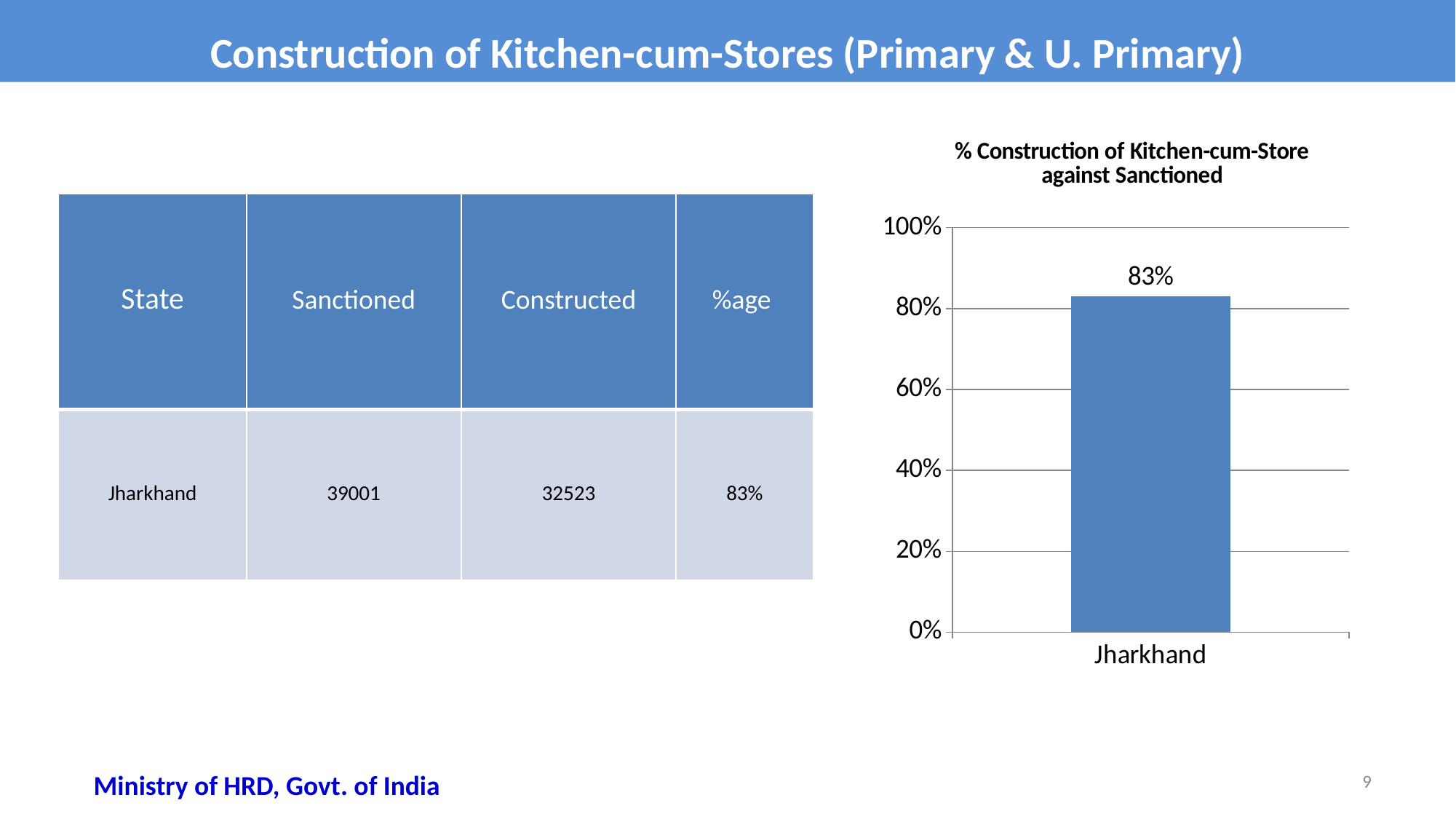
What kind of chart is shown on the slide? bar chart What is the title of the chart? % Construction of Kitchen-cum-Store against Sanctioned What is the value shown for Jharkhand in the chart? 83% How many categories are plotted in the chart? 1 Is the value for Jharkhand greater or less than 100%? less Is the value for Jharkhand greater or less than 80%? greater Which category is labelled on the x axis of the chart? Jharkhand What is the highest value shown on the chart's vertical axis? 100%